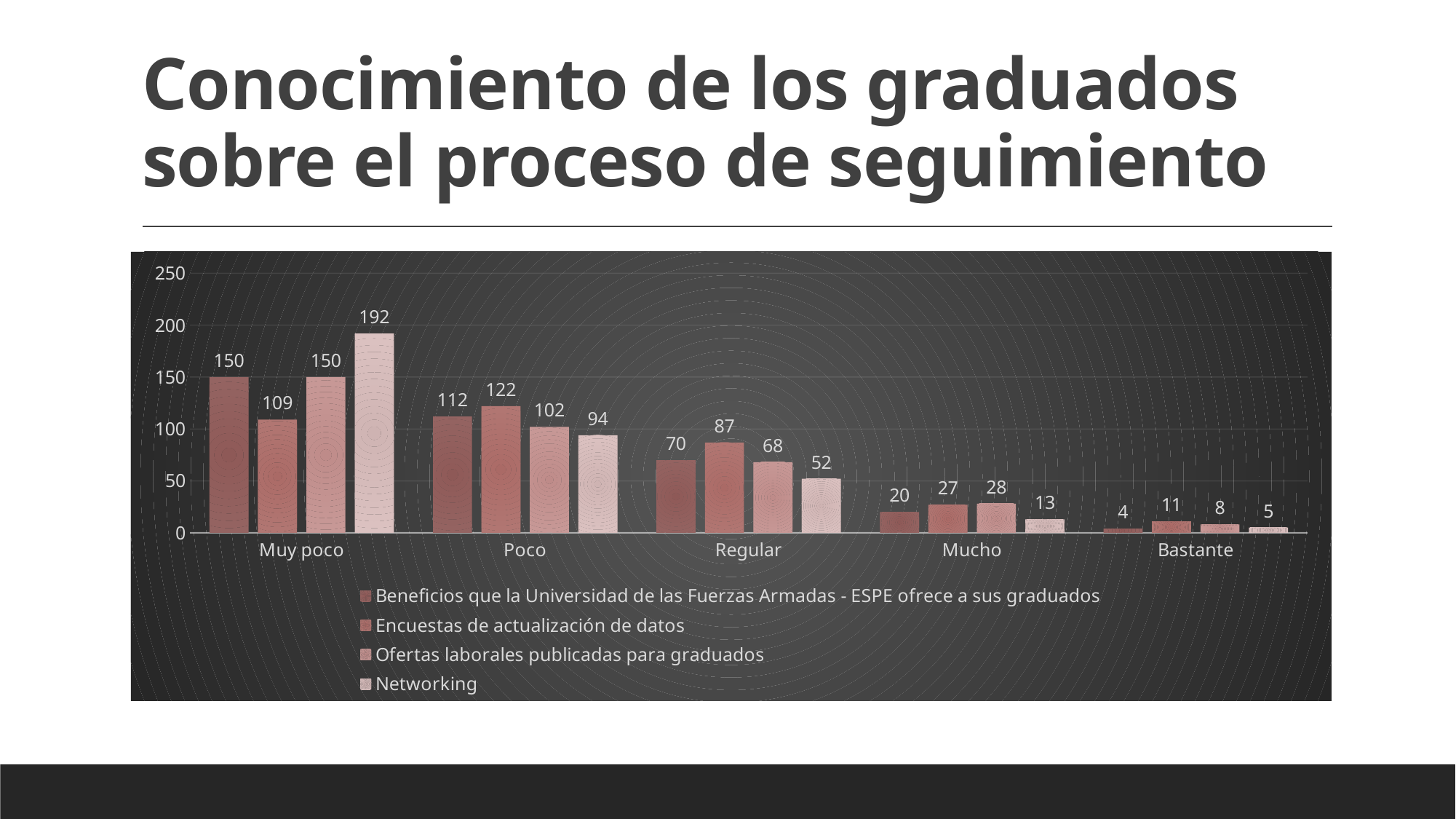
How many series does the legend list? 4 In the Poco category, which is larger: Beneficios que la Universidad de las Fuerzas Armadas - ESPE ofrece a sus graduados or Encuestas de actualización de datos? Encuestas de actualización de datos What is the value for Ofertas laborales publicadas para graduados in the Regular category? 68 Do the values for Networking rise or fall from Muy poco to Bastante? Fall What is the value for Encuestas de actualización de datos in the Poco category? 122 Which category has the lowest value for Encuestas de actualización de datos? Bastante What is the difference between the Networking value and the Encuestas de actualización de datos value in the Muy poco category? 83 What is the value for Beneficios que la Universidad de las Fuerzas Armadas - ESPE ofrece a sus graduados in the Bastante category? 4 Which category has the highest value for Networking? Muy poco How many categories are shown on the x axis? 5 What is the value for Networking in the Muy poco category? 192 What kind of chart is shown on the slide? Bar chart